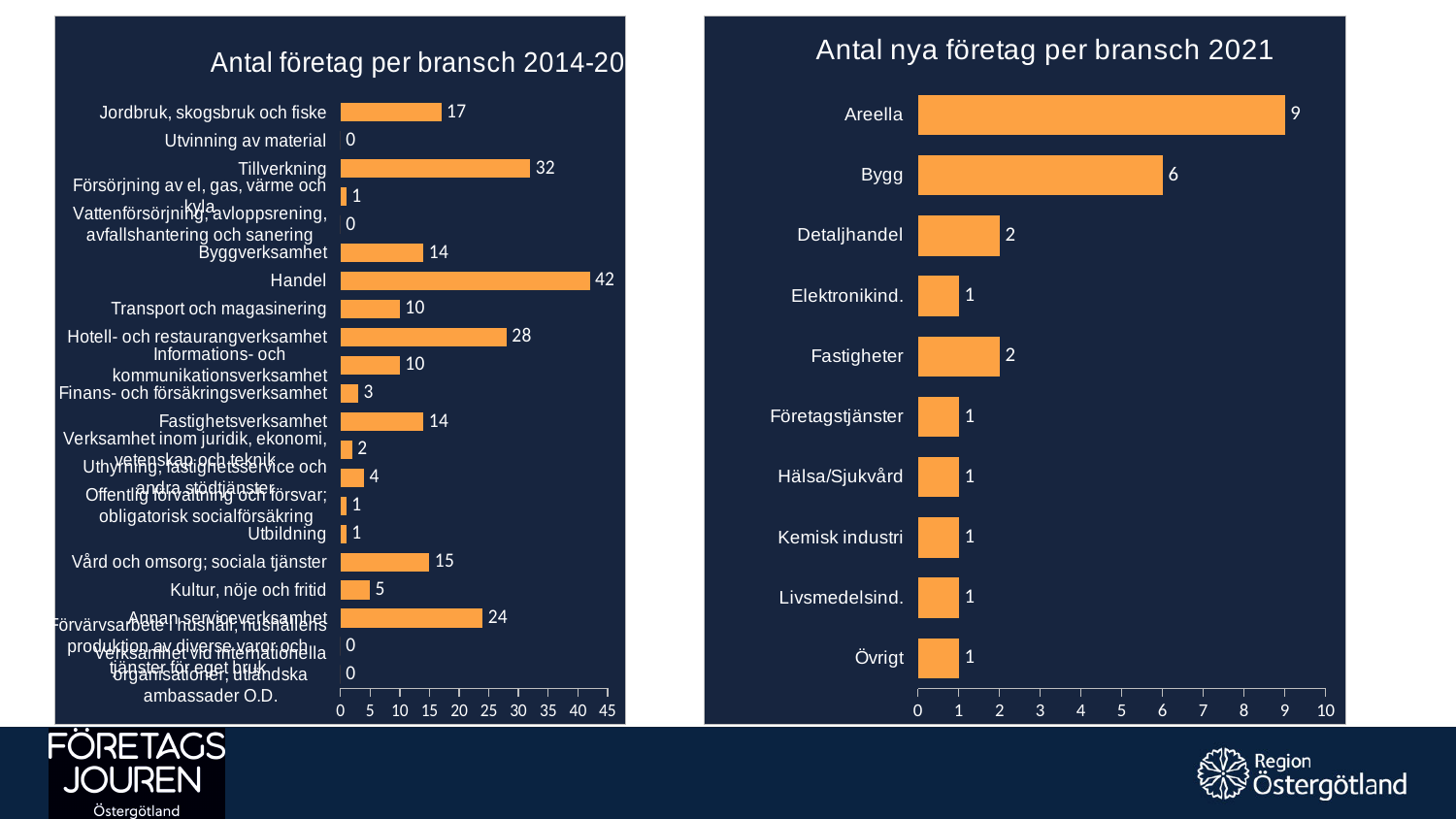
In the right chart (Antal nya företag per bransch 2021), what is the value for Areella? 9 In the right chart (Antal nya företag per bransch 2021), what is the difference between Areella and Bygg? 3 In the right chart (Antal nya företag per bransch 2021), what is the value for Bygg? 6 In the left chart (Antal företag per bransch), what is the value for Handel? 42 In the left chart (Antal företag per bransch), which is larger: Hotell- och restaurangverksamhet or Vård och omsorg; sociala tjänster? Hotell- och restaurangverksamhet What kind of chart is the right chart (Antal nya företag per bransch 2021)? Bar chart In the right chart (Antal nya företag per bransch 2021), how many categories are shown? 10 In the left chart (Antal företag per bransch), what is the value for Kultur, nöje och fritid? 5 In the right chart (Antal nya företag per bransch 2021), which category has the highest value? Areella In the left chart (Antal företag per bransch), what is the difference between Handel and Tillverkning? 10 In the left chart (Antal företag per bransch), which category has the highest value? Handel In the left chart (Antal företag per bransch), what is the value for Tillverkning? 32